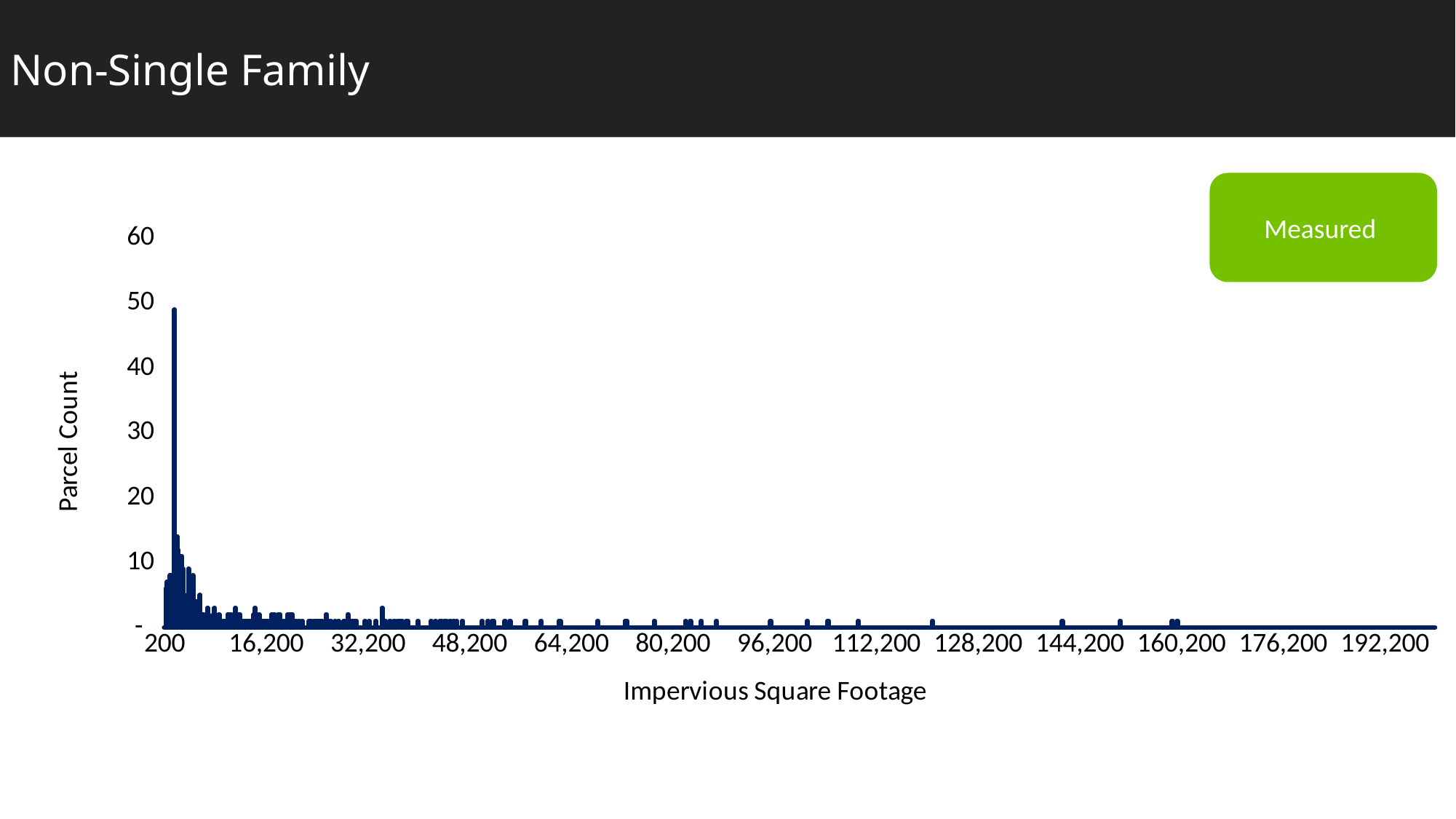
What kind of chart is shown on the slide? Bar chart What is the highest tick value shown on the Parcel Count axis? 60 Is the tallest bar in the chart greater or less than 40 on the Parcel Count axis? greater Are the bars near 176,200 on the x axis greater or less than 10 on the Parcel Count axis? less What is the title of the slide containing the chart? Non-Single Family Do the parcel counts generally rise or fall as impervious square footage increases along the x axis? fall What is the label of the vertical axis of the chart? Parcel Count Near which end of the Impervious Square Footage axis is the tallest bar located, the low end near 200 or the high end near 192,200? the low end near 200